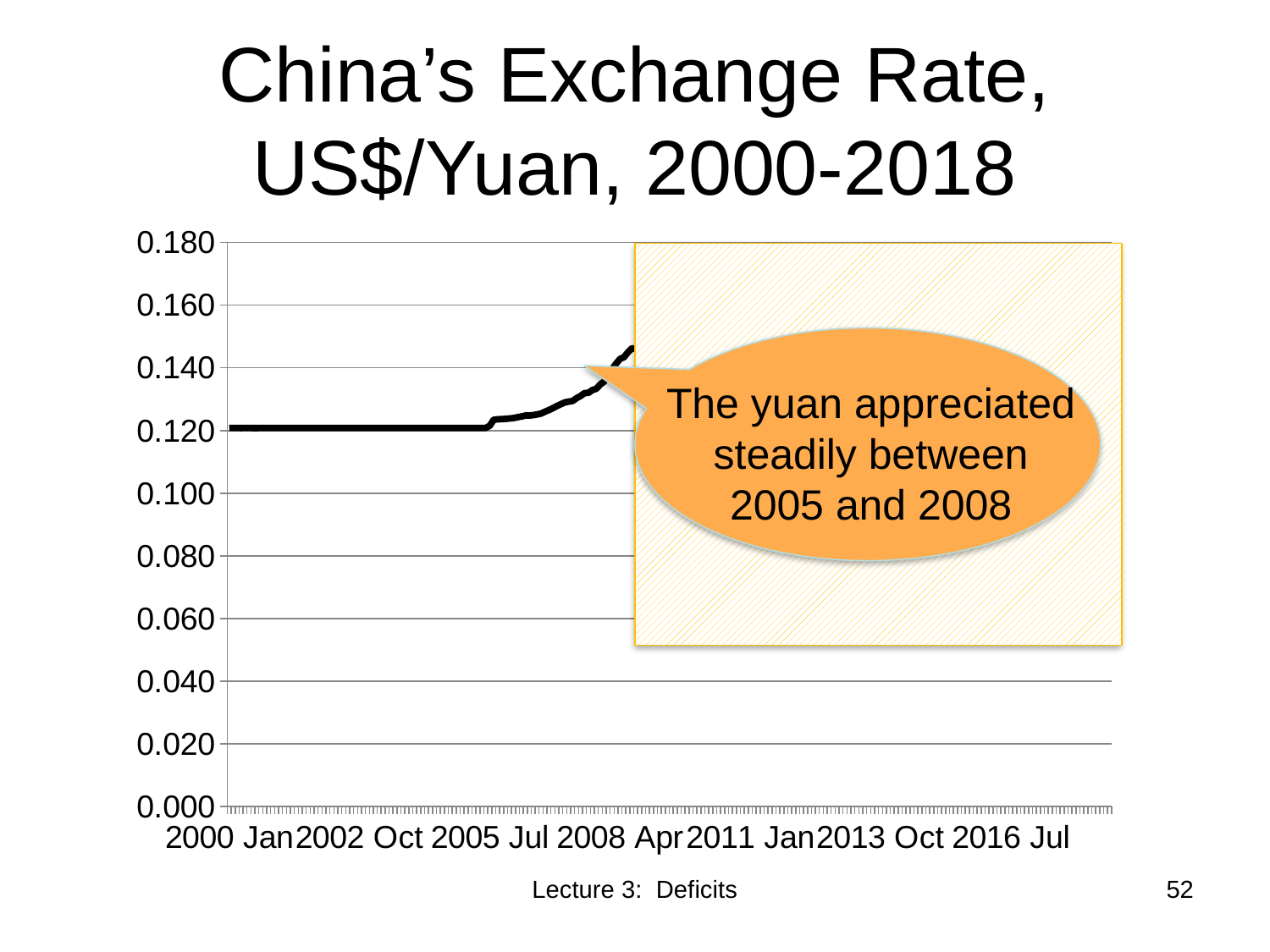
Does the exchange rate rise or fall between 2005 Jul and 2008 Apr? rises Is the exchange rate in 2000 Jan greater or less than 0.100? greater What is the highest value shown on the y axis? 0.180 What kind of chart is shown on the slide? line chart What is the title of the chart on the slide? China's Exchange Rate, US$/Yuan, 2000-2018 Which is larger, the exchange rate in 2002 Oct or in early 2008? early 2008 Is the exchange rate in early 2008 greater or less than 0.160? less What does the callout on the chart say? The yuan appreciated steadily between 2005 and 2008 How many date labels are shown on the x axis? 7 Is the exchange rate in 2002 Oct greater or less than 0.140? less Does the exchange rate rise, fall, or stay flat between 2000 Jan and 2005 Jul? stays flat